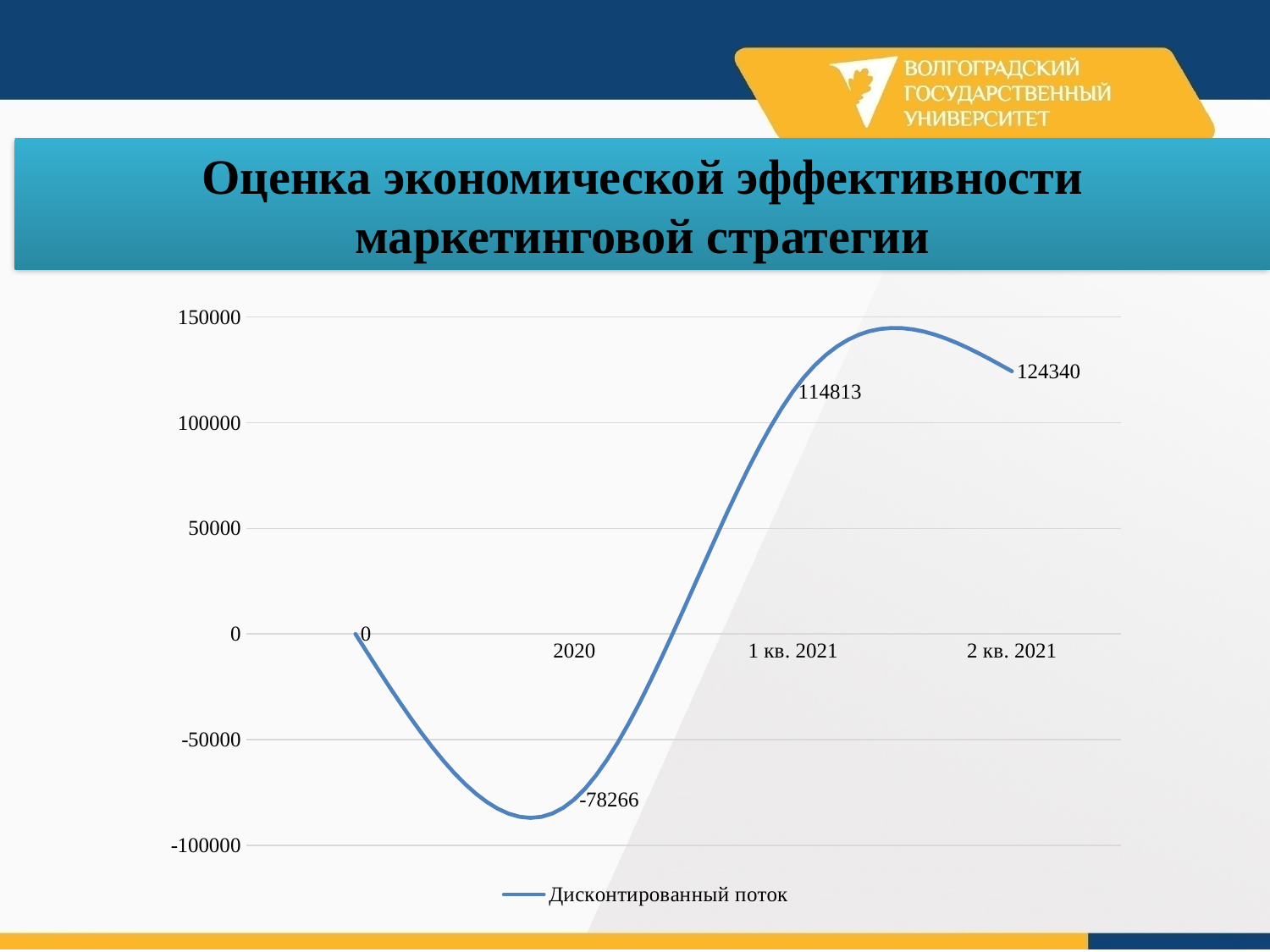
Which labelled period has the highest discounted flow value? 2 кв. 2021 Is the discounted flow value for 2020 greater or less than -50000? less Which is larger, the discounted flow for 1 кв. 2021 or for 2 кв. 2021? 2 кв. 2021 What is the value of the discounted flow (Дисконтированный поток) for 2020? -78266 Which labelled period has the lowest discounted flow value? 2020 What is the value of the discounted flow for 1 кв. 2021? 114813 What kind of chart is shown on the slide? line chart What is the value of the discounted flow for 2 кв. 2021? 124340 What is the difference between the discounted flow values for 2 кв. 2021 and 1 кв. 2021? 9527 How many data points are plotted on the line? 4 How many series does the legend list? 1 What is the name of the series shown in the legend? Дисконтированный поток